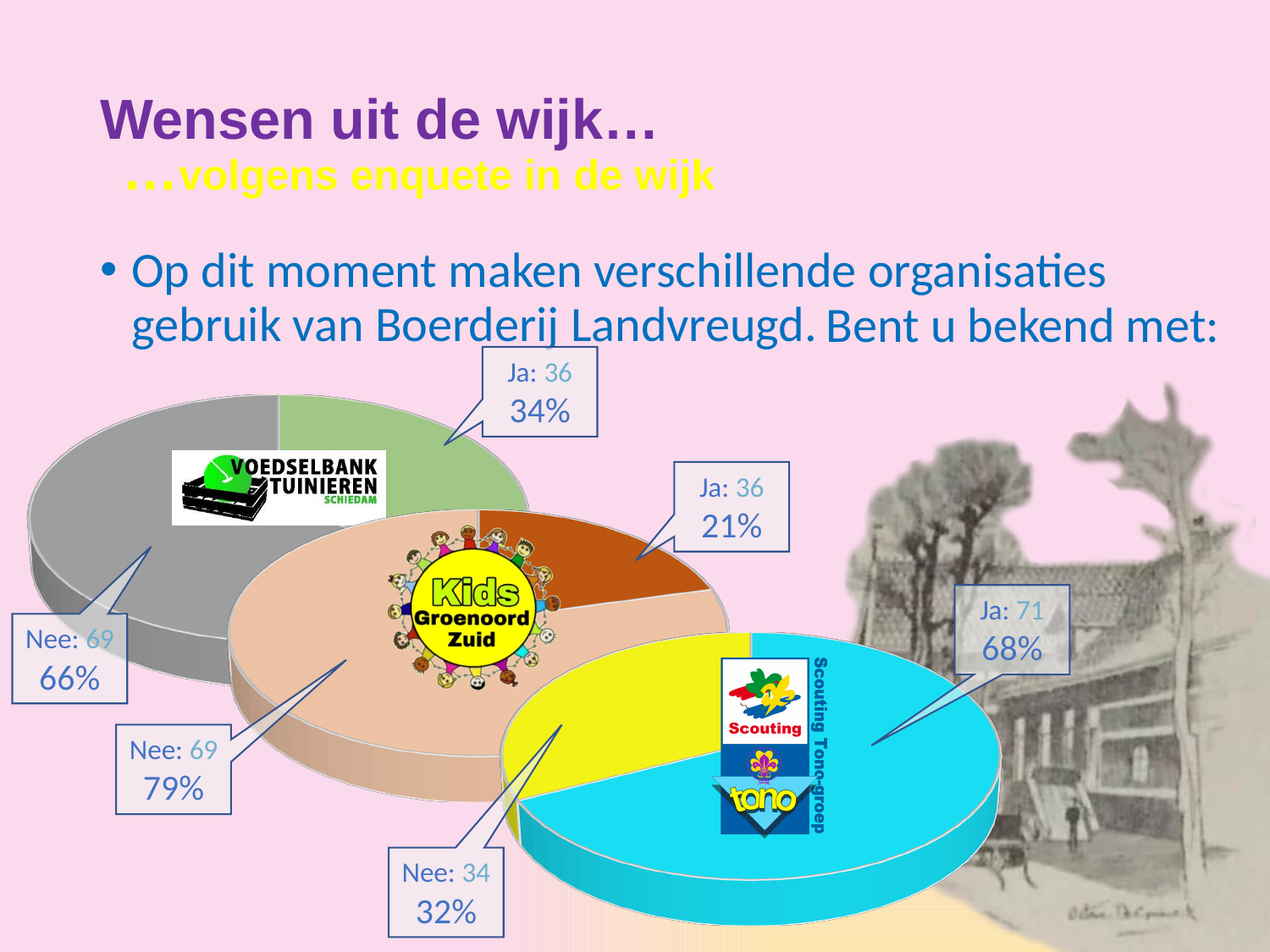
What type of chart is used on this slide? Pie chart In the Kids Groenoord Zuid pie chart (middle), what percentage is shown for 'Ja'? 21% In the Voedselbank Tuinieren pie chart (top left), what percentage is shown for 'Ja'? 34% In the Scouting Tono-groep pie chart (bottom right), which slice is larger, 'Ja' or 'Nee'? Ja In the Scouting Tono-groep pie chart (bottom right), what is the difference between the 'Ja' count and the 'Nee' count? 37 In the Scouting Tono-groep pie chart (bottom right), what percentage is shown for 'Nee'? 32% In the Scouting Tono-groep pie chart (bottom right), what count is shown for 'Ja'? 71 How many pie charts are shown on the slide? 3 In the Kids Groenoord Zuid pie chart (middle), which slice is the smallest? Ja In the Voedselbank Tuinieren pie chart (top left), which slice is the largest? Nee In the Kids Groenoord Zuid pie chart (middle), what percentage is shown for 'Nee'? 79% In the Voedselbank Tuinieren pie chart (top left), what count is shown for 'Nee'? 69